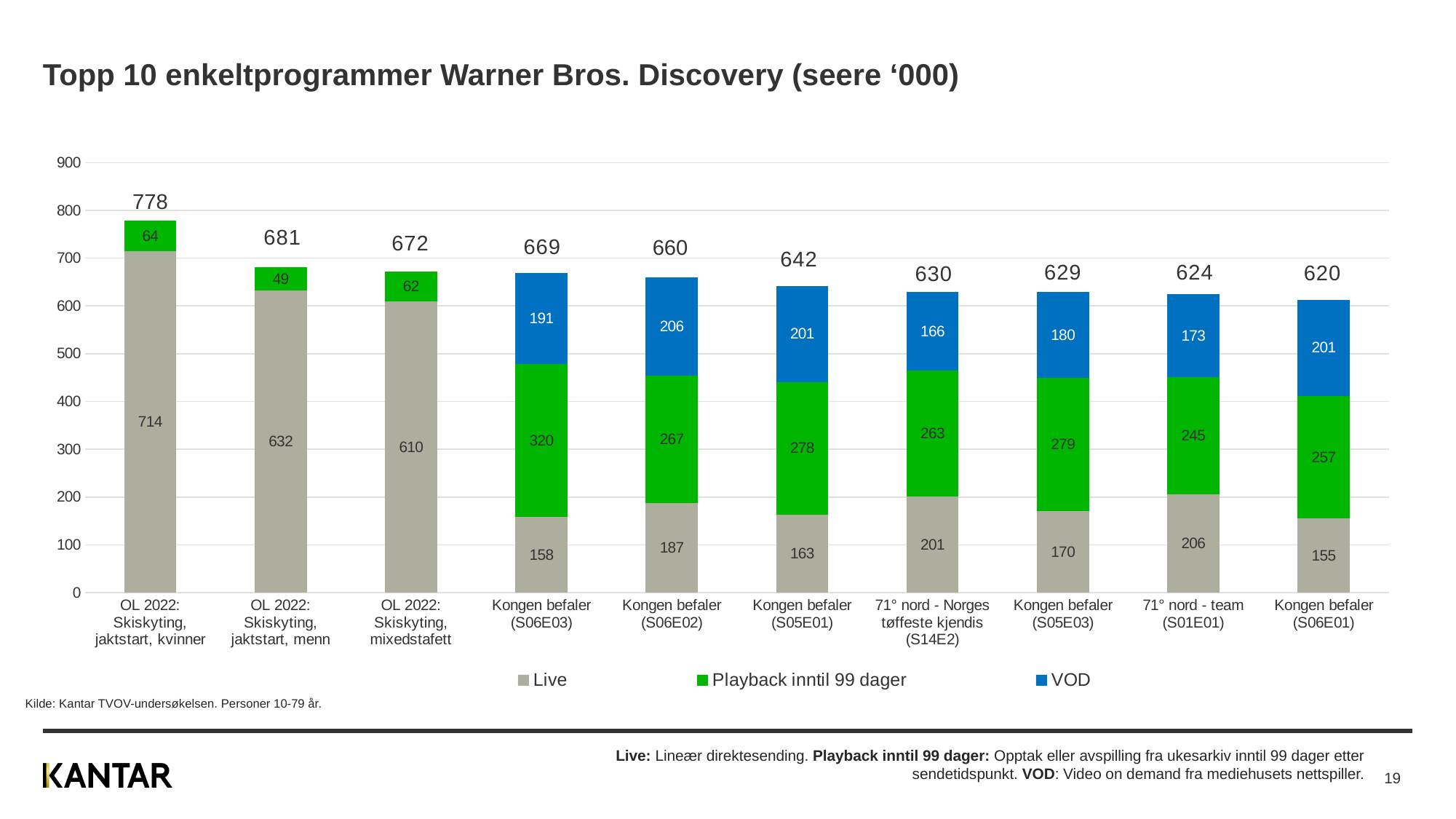
What is the difference between the total for OL 2022: Skiskyting, jaktstart, kvinner and the total for Kongen befaler (S06E01)? 158 How many series does the legend list? 3 Which program has the lowest total number of viewers? Kongen befaler (S06E01) Which is larger: the Live value for 71° nord - team (S01E01) or the Live value for Kongen befaler (S05E03)? 71° nord - team (S01E01) How many programs are shown on the chart? 10 Do the total values rise or fall from left to right along the x axis? Fall What is the Live value for OL 2022: Skiskyting, jaktstart, kvinner? 714 What is the total of the stacked bar for Kongen befaler (S05E01)? 642 Which program has the highest total number of viewers? OL 2022: Skiskyting, jaktstart, kvinner What is the VOD value for Kongen befaler (S06E02)? 206 What is the Playback inntil 99 dager value for Kongen befaler (S06E03)? 320 What kind of chart is shown on the slide? Stacked bar chart